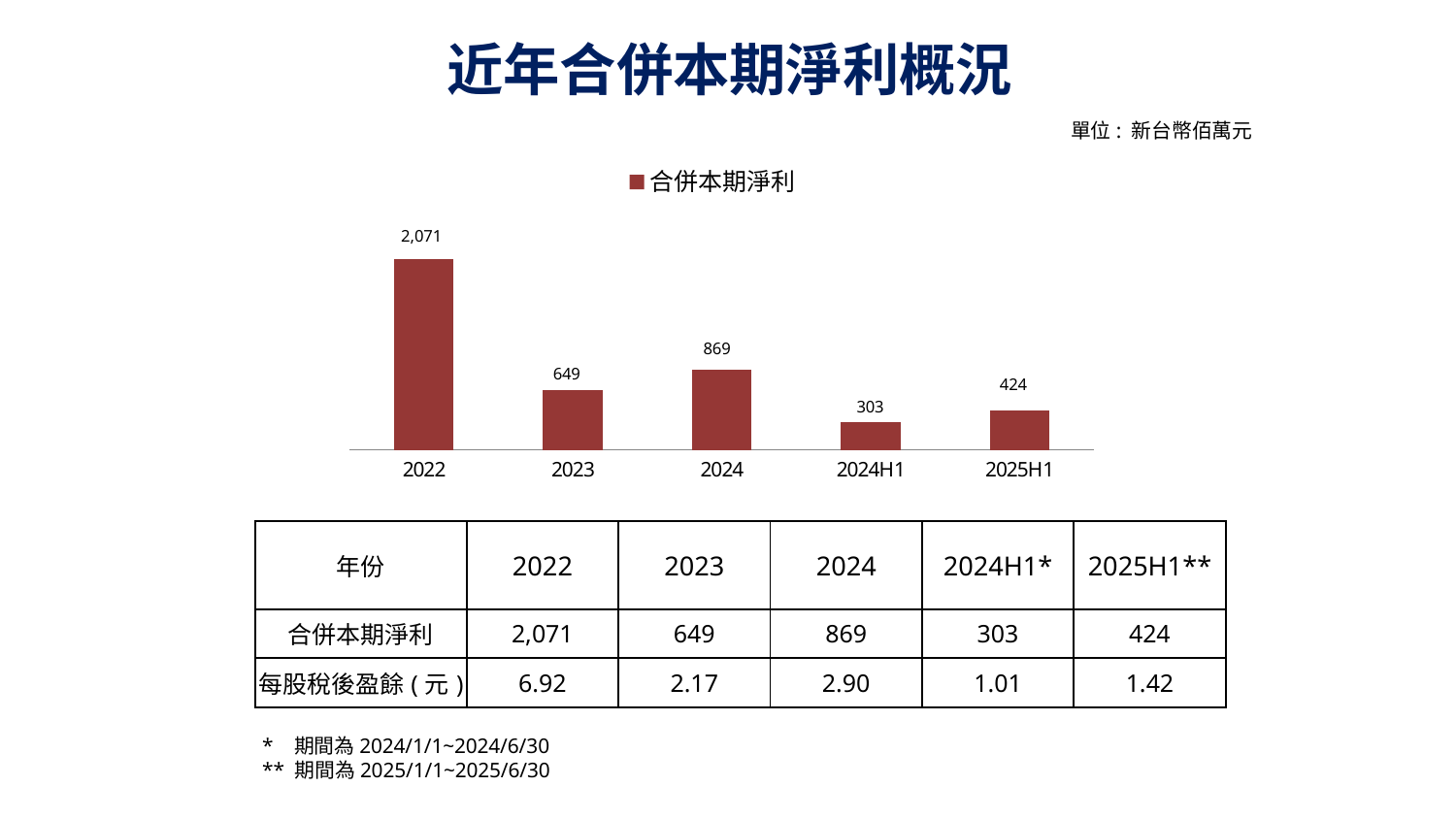
Which category has the highest value in the 合併本期淨利 chart? 2022 How many categories are shown on the x axis of the 合併本期淨利 chart? 5 Which category has the lowest value in the 合併本期淨利 chart? 2024H1 How many series does the legend of the chart list? 1 What is the value for 2024H1 in the 合併本期淨利 chart? 303 What is the value for 2025H1 in the 合併本期淨利 chart? 424 Which is larger in the 合併本期淨利 chart, the value for 2023 or the value for 2024? 2024 What is the legend entry shown above the chart? 合併本期淨利 What kind of chart is shown on the slide? Bar chart What is the difference between the 2024 and 2023 values in the 合併本期淨利 chart? 220 What is the difference between the 2025H1 and 2024H1 values in the 合併本期淨利 chart? 121 What is the value for 2022 in the 合併本期淨利 chart? 2,071